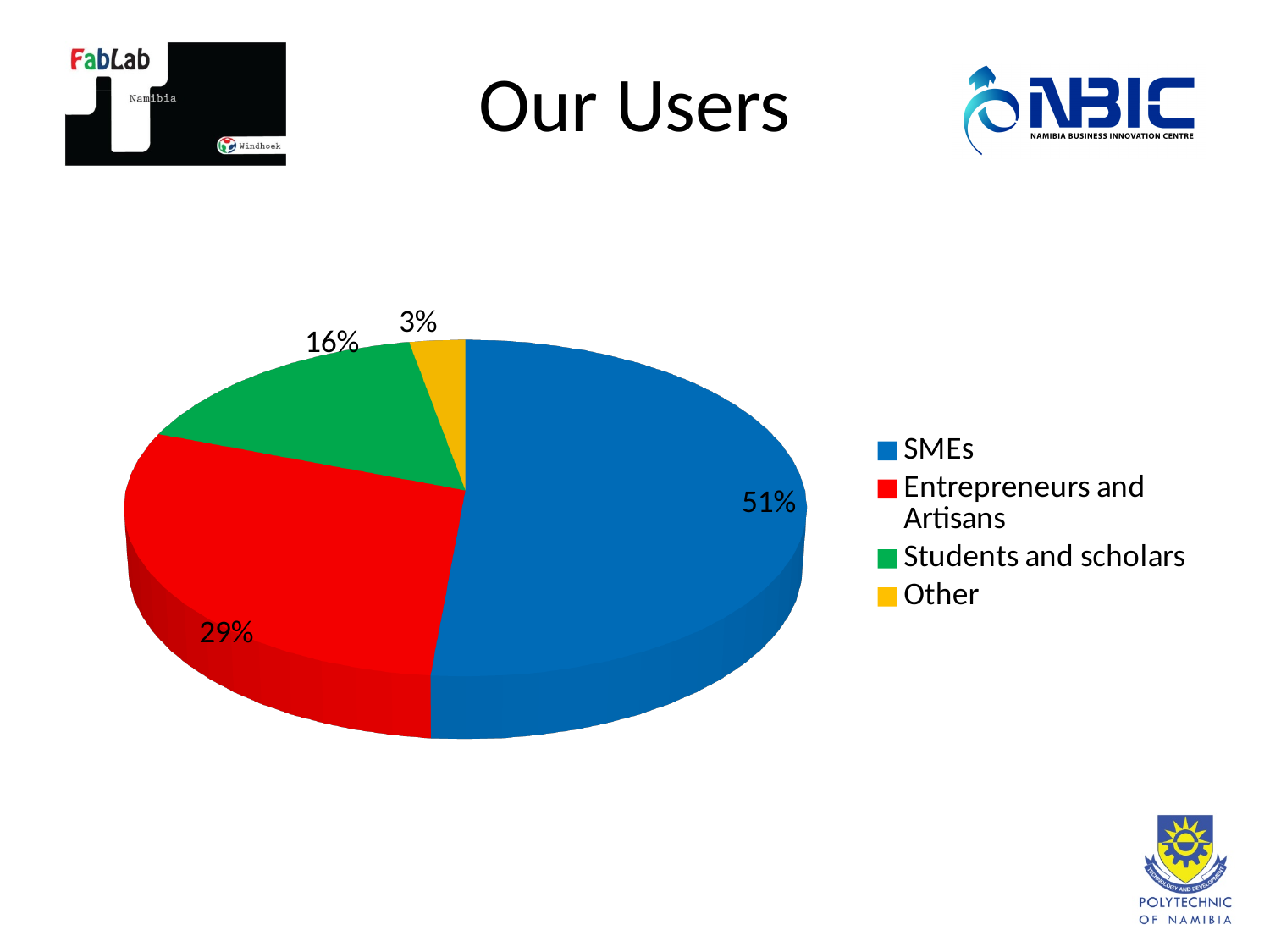
What is the difference in percentage points between SMEs and Entrepreneurs and Artisans? 22 What share of users are Students and scholars? 16% How many categories does the pie chart show? 4 Which is larger, the share for Students and scholars or the share for Other? Students and scholars What share of users are SMEs? 51% What colour represents Students and scholars in the pie chart? Green Which user category has the largest share? SMEs What type of chart is shown on the slide? Pie chart What is the title of the slide containing the chart? Our Users Which user category has the smallest share? Other What share of users fall under Other? 3% What share of users are Entrepreneurs and Artisans? 29%